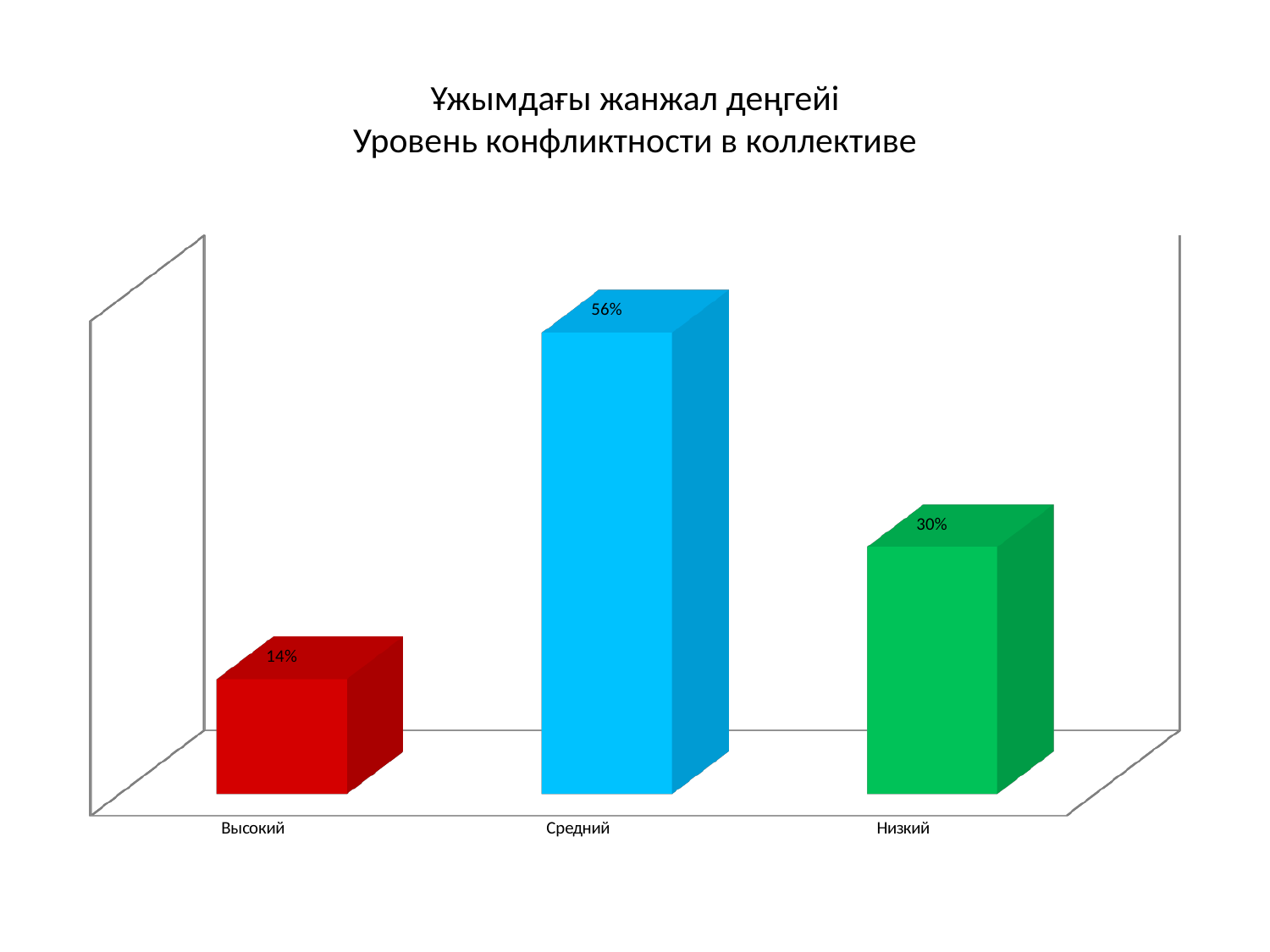
What colour is the bar for Средний? Blue What kind of chart is shown on the slide? Bar chart Which category has the highest value? Средний What is the value for Средний? 56% What is the difference between the values for Средний and Низкий? 26% What is the value for Низкий? 30% How many categories are shown on the chart? 3 Which category has the lowest value? Высокий Which is larger, the value for Низкий or the value for Высокий? Низкий What is the difference between the values for Низкий and Высокий? 16% What is the value for Высокий? 14% What is the Russian title of the chart? Уровень конфликтности в коллективе